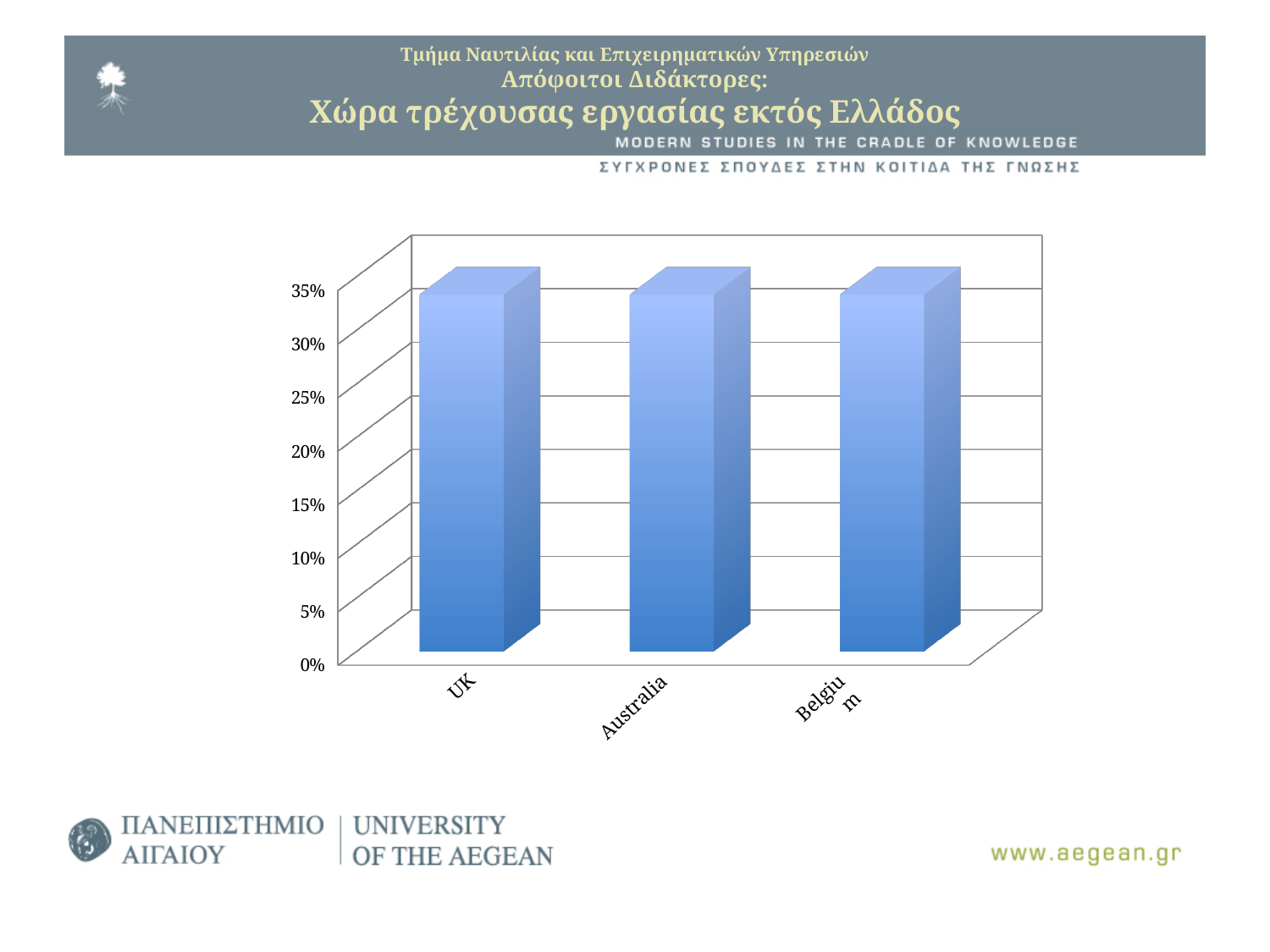
What is the highest value shown on the vertical axis of the chart? 35% Is the value for Belgium greater or less than 20%? greater Is the value for Australia greater or less than 30%? greater Is the value for UK greater or less than 25%? greater Which countries are listed on the x axis of the chart? UK, Australia, Belgium Do the values rise, fall, or stay about the same across the countries from UK to Belgium? stay about the same What kind of chart is shown on the slide? bar chart How many countries are shown on the x axis of the chart? 3